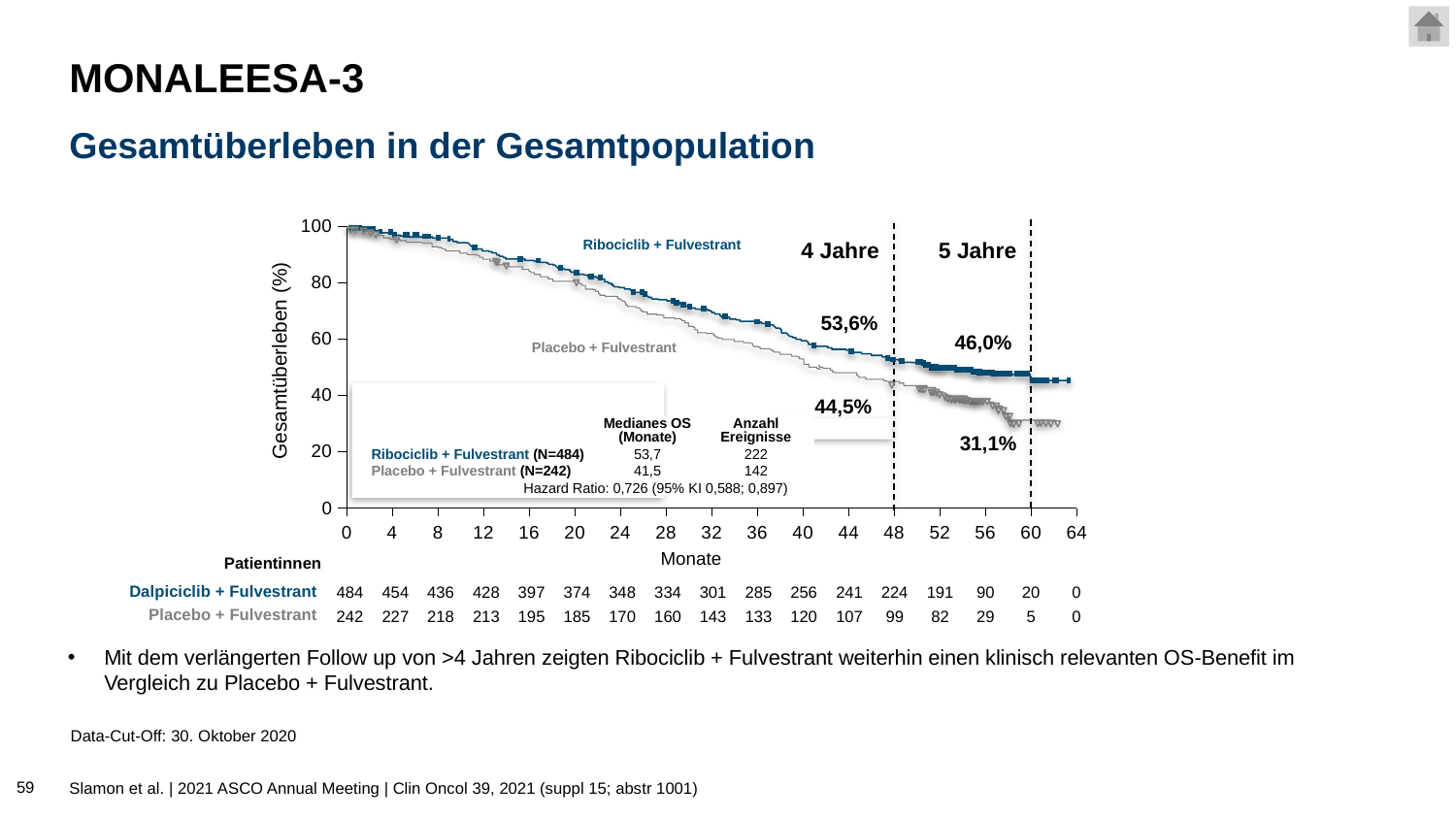
What is the 4-year overall survival rate shown for Ribociclib + Fulvestrant? 53,6% What is the 5-year overall survival rate shown for Placebo + Fulvestrant? 31,1% Which arm has the higher 4-year overall survival rate? Ribociclib + Fulvestrant How many events (Anzahl Ereignisse) are reported for the Placebo + Fulvestrant arm? 142 What is the median overall survival in months for Ribociclib + Fulvestrant? 53,7 What is the 5-year overall survival rate shown for Ribociclib + Fulvestrant? 46,0% What is the hazard ratio shown on the chart? 0,726 What is the difference in 5-year overall survival between Ribociclib + Fulvestrant and Placebo + Fulvestrant? 14,9 percentage points What is the 4-year overall survival rate shown for Placebo + Fulvestrant? 44,5% Do the survival curves rise or fall as months increase along the x axis? fall What kind of chart is shown on the slide? line chart (Kaplan-Meier survival curve) What is the median overall survival in months for Placebo + Fulvestrant? 41,5